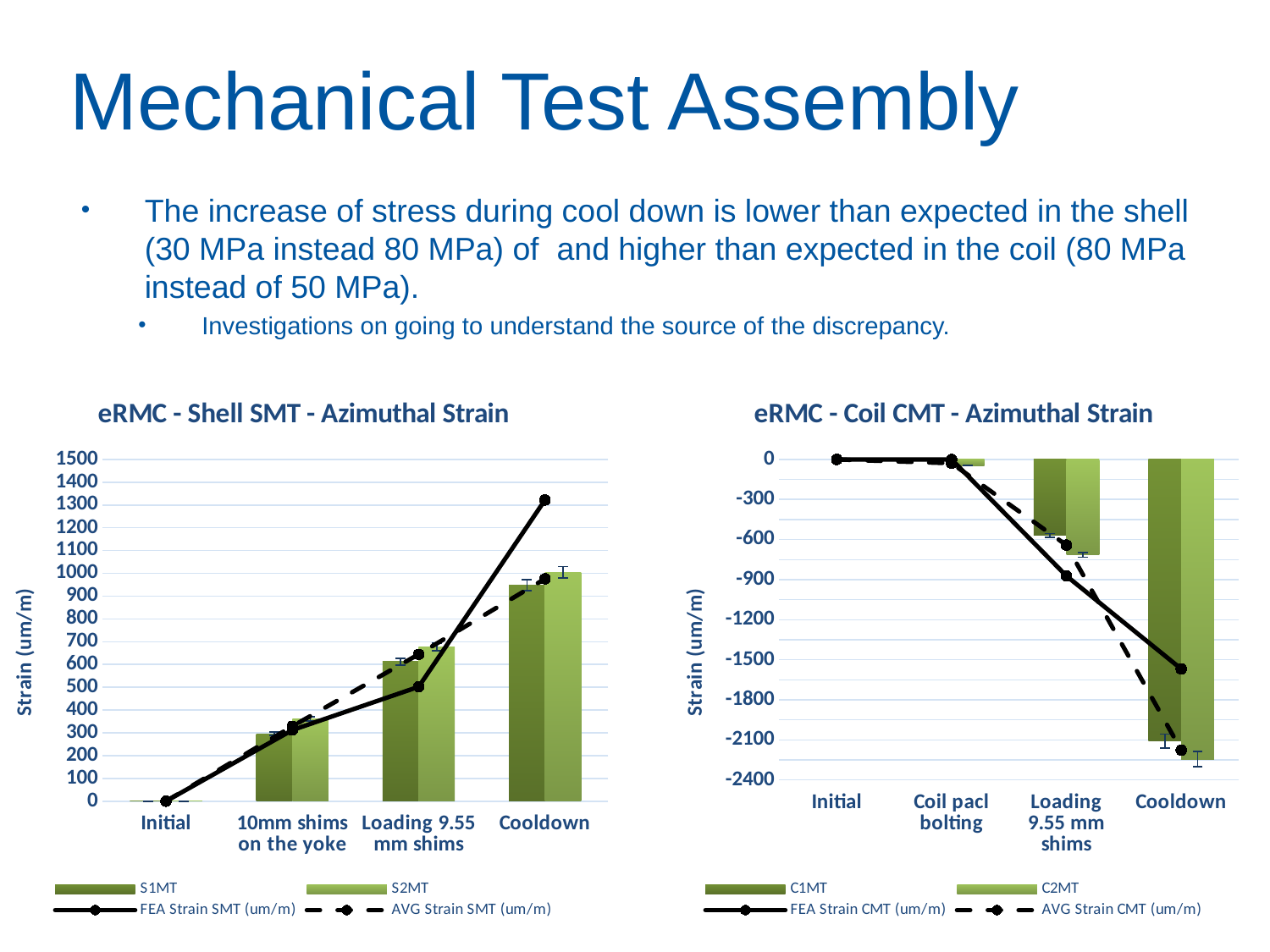
What kind of chart is the 'eRMC - Shell SMT - Azimuthal Strain' chart? bar and line chart How many series does the legend of the 'eRMC - Coil CMT - Azimuthal Strain' chart list? 4 In the 'eRMC - Shell SMT - Azimuthal Strain' chart, do the S1MT bars rise or fall from Initial to Cooldown? rise In the 'eRMC - Shell SMT - Azimuthal Strain' chart, is the FEA Strain SMT value at Cooldown greater or less than 1200? greater In the 'eRMC - Shell SMT - Azimuthal Strain' chart, is the S2MT value at Cooldown greater or less than 900? greater In the 'eRMC - Shell SMT - Azimuthal Strain' chart, which category has the highest S1MT bar? Cooldown In the 'eRMC - Shell SMT - Azimuthal Strain' chart, is the S1MT value at 'Loading 9.55 mm shims' greater or less than 500? greater How many series does the legend of the 'eRMC - Shell SMT - Azimuthal Strain' chart list? 4 What is the y-axis title of the 'eRMC - Coil CMT - Azimuthal Strain' chart? Strain (um/m) How many categories are shown on the x axis of the 'eRMC - Shell SMT - Azimuthal Strain' chart? 4 How many categories are shown on the x axis of the 'eRMC - Coil CMT - Azimuthal Strain' chart? 4